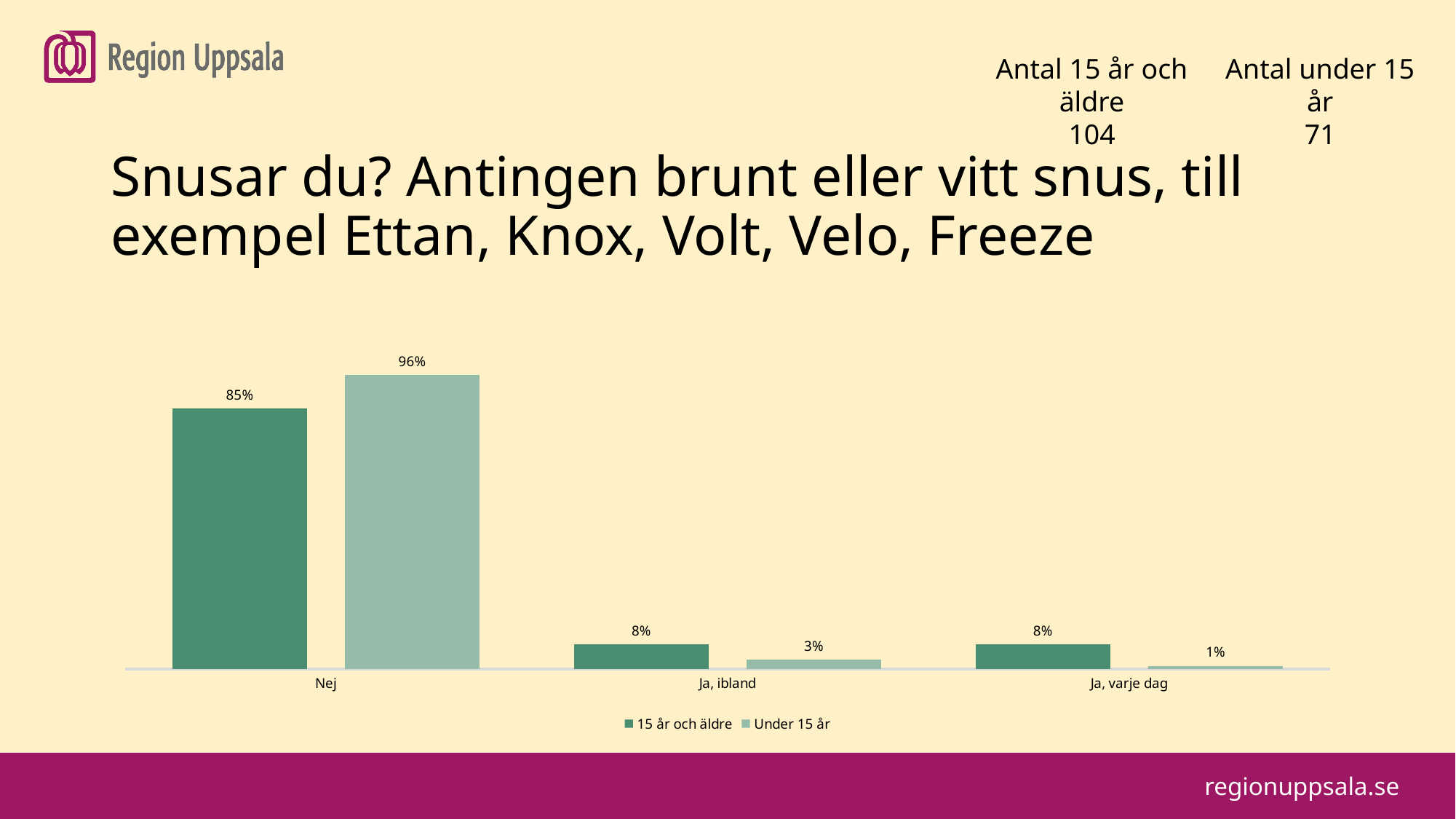
How many categories are shown on the x axis? 3 Which category has the lowest value for the "Under 15 år" series? Ja, varje dag How many series does the legend list? 2 What kind of chart is shown on the slide? Bar chart What is the value for "15 år och äldre" in the "Ja, varje dag" category? 8% What is the value for "15 år och äldre" in the "Nej" category? 85% Which category has the highest value for the "Under 15 år" series? Nej What is the value for "Under 15 år" in the "Ja, ibland" category? 3% What is the value for "Under 15 år" in the "Ja, varje dag" category? 1% What is the difference between the "Under 15 år" and "15 år och äldre" values in the "Nej" category? 11 percentage points What is the value for "Under 15 år" in the "Nej" category? 96% In the "Ja, ibland" category, which series has the larger value? 15 år och äldre